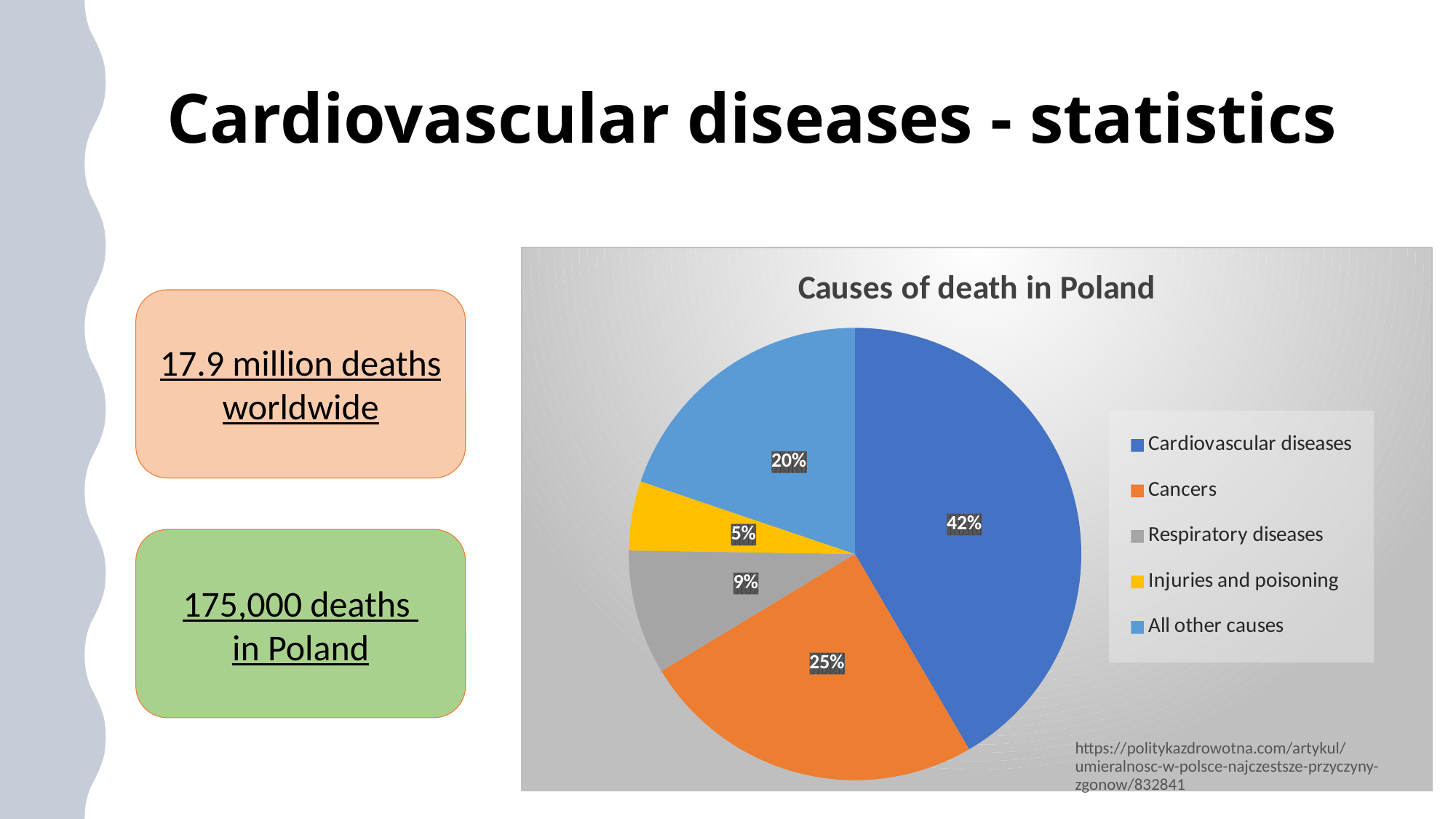
What type of chart is shown on the slide? Pie chart What is the difference in percentage points between Cardiovascular diseases and Cancers? 17 What share of deaths in Poland is attributed to Injuries and poisoning? 5% Which cause of death has the smallest slice of the pie? Injuries and poisoning What share of deaths in Poland is attributed to Respiratory diseases? 9% Which cause of death has the largest slice of the pie? Cardiovascular diseases What colour is the slice for Injuries and poisoning? Yellow Which is larger, the share for All other causes or the share for Respiratory diseases? All other causes How many categories does the pie chart show? 5 What is the title of the chart? Causes of death in Poland What share of deaths in Poland is attributed to Cancers? 25% What share of deaths in Poland is attributed to Cardiovascular diseases? 42%